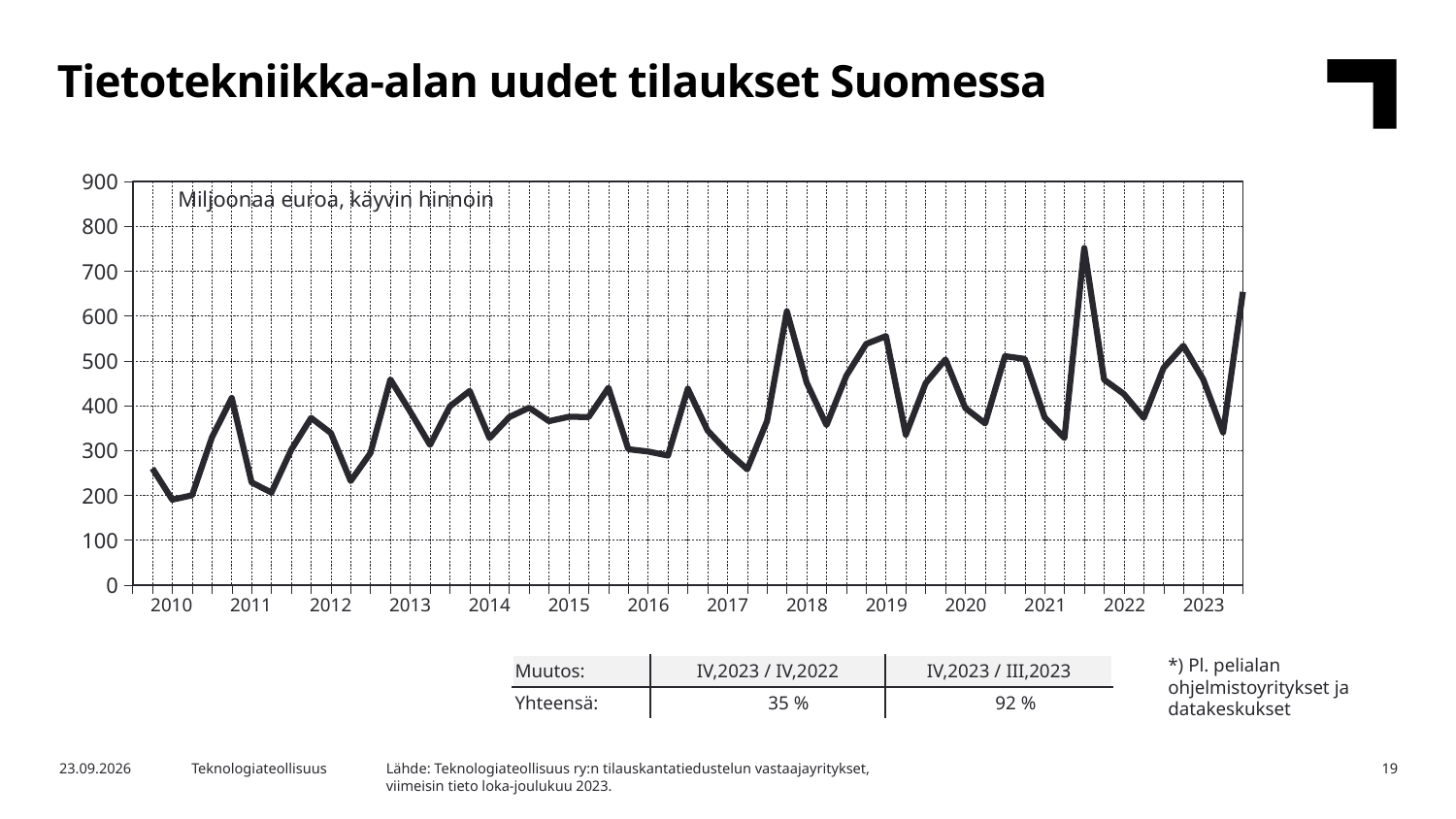
In what unit are the values on the chart expressed, according to the label inside the plot area? Miljoonaa euroa, käyvin hinnoin What is the last year labelled on the x axis? 2023 Is the peak of the line in 2021 higher or lower than the peak in 2018? higher What is the highest value shown on the y axis of the chart? 900 Is the first value of the line, at the start of 2010, greater or less than 300? less Is the last value of the line, at the end of 2023, greater or less than 600? greater How many year labels are shown along the x axis of the chart? 14 What is the title of the chart on the slide? Tietotekniikka-alan uudet tilaukset Suomessa In which year does the line reach its highest peak? 2021 Is the highest peak of the line, in 2021, greater or less than 700? greater What is the first year labelled on the x axis? 2010 What kind of chart is shown on the slide? line chart